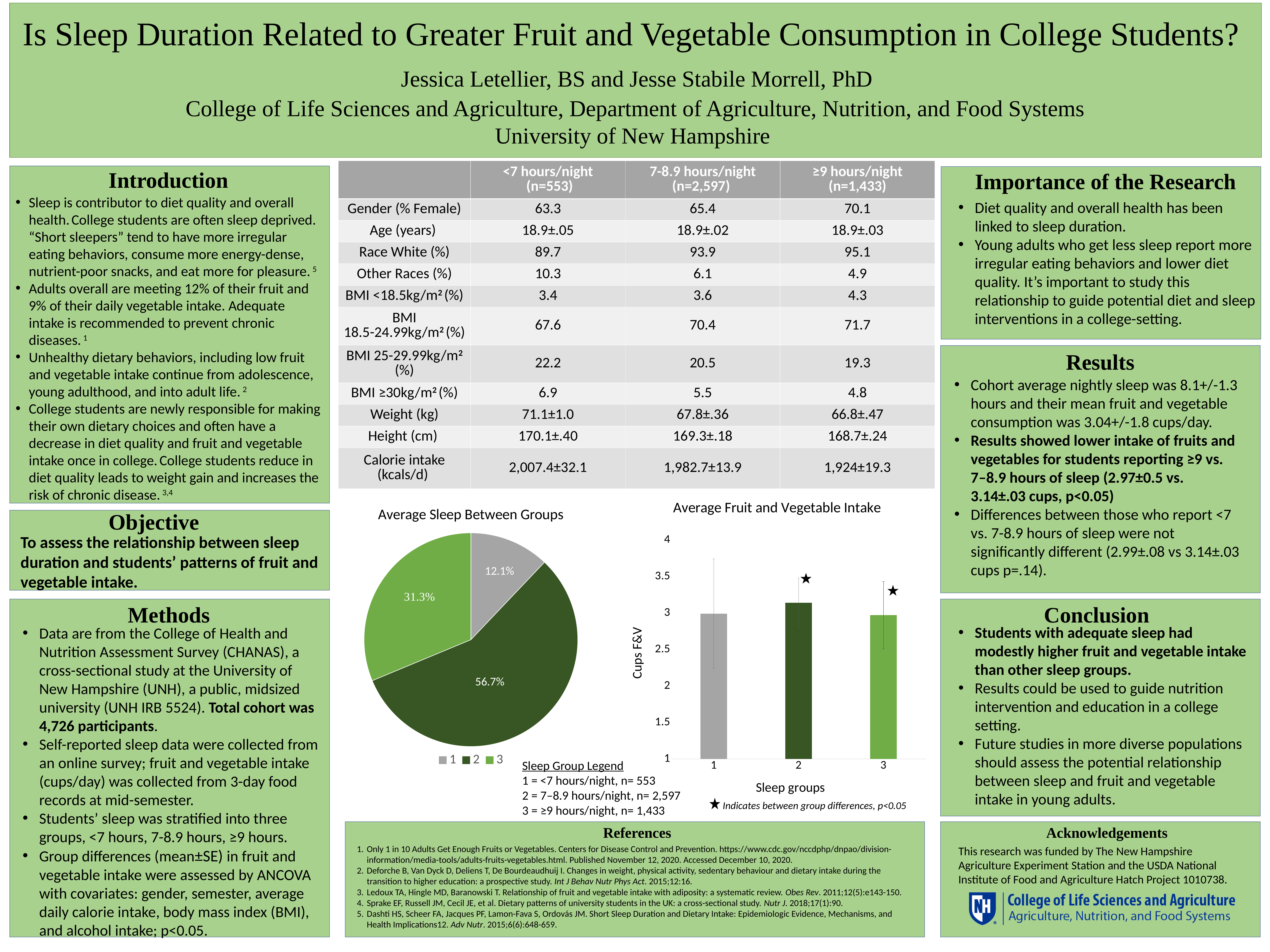
In the pie chart titled "Average Sleep Between Groups", what is the difference in percentage points between slice 2 and slice 3? 25.4 In the pie chart titled "Average Sleep Between Groups", what share does slice 3 have? 31.3% What is the y-axis label of the chart titled "Average Fruit and Vegetable Intake"? Cups F&V How many slices does the pie chart titled "Average Sleep Between Groups" have? 3 What kind of chart is the chart titled "Average Sleep Between Groups"? pie chart What kind of chart is the chart titled "Average Fruit and Vegetable Intake"? bar chart In the pie chart titled "Average Sleep Between Groups", which group has the largest slice? 2 In the chart titled "Average Fruit and Vegetable Intake", which sleep group has the highest bar? 2 In the chart titled "Average Fruit and Vegetable Intake", is the value for sleep group 2 greater or less than 3? greater In the pie chart titled "Average Sleep Between Groups", which group has the smallest slice? 1 In the pie chart titled "Average Sleep Between Groups", what share does slice 1 have? 12.1% In the pie chart titled "Average Sleep Between Groups", what share does slice 2 have? 56.7%